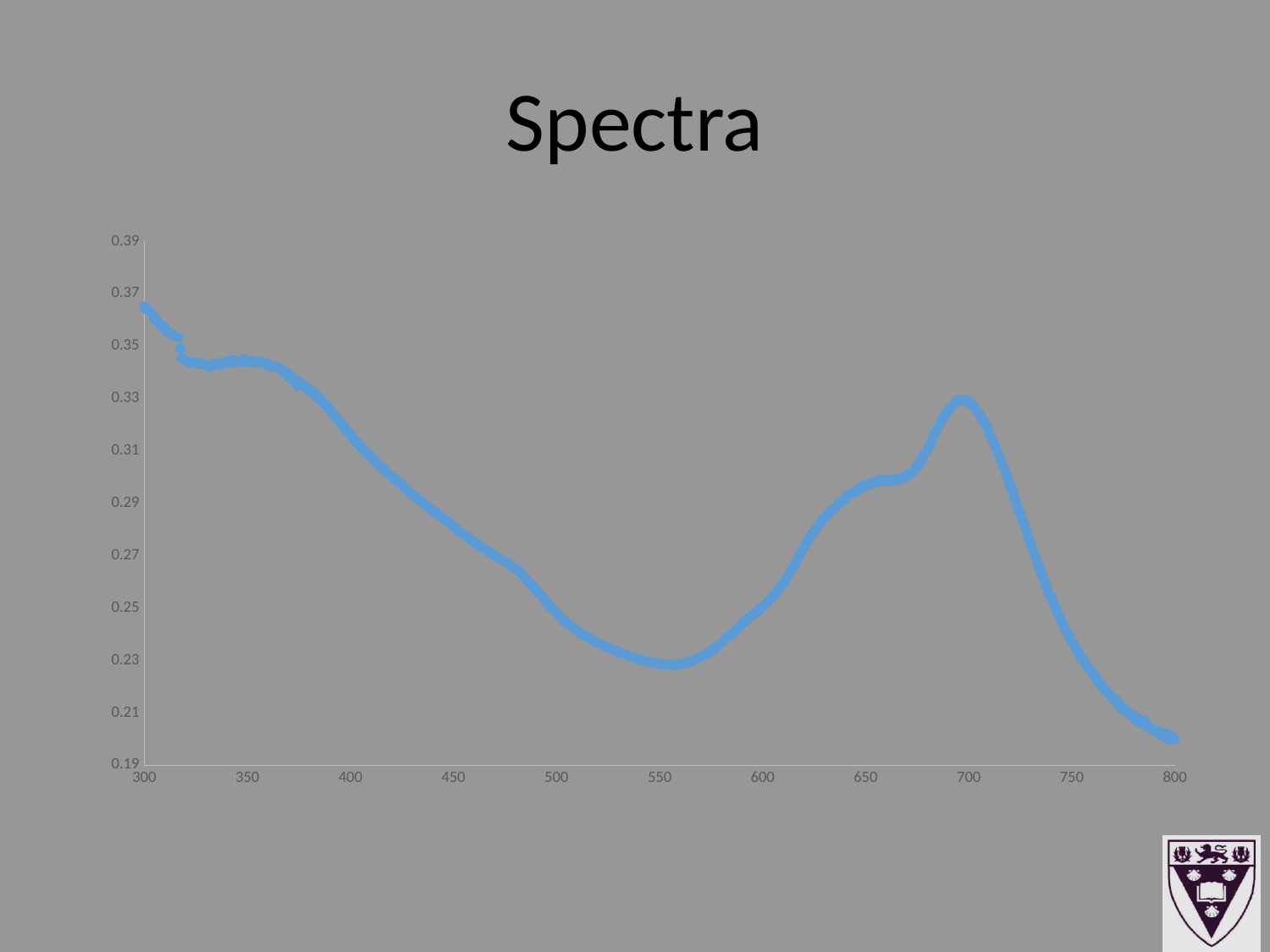
What is the range of the x axis shown on the chart? 300 to 800 What type of chart is shown on the slide? line chart Is the value at x = 700 greater or less than 0.31? greater Is the value at x = 300 greater or less than 0.35? greater Does the line rise or fall between x = 550 and x = 700? rise What is the title of the chart? Spectra Is the value at x = 800 greater or less than 0.21? less Does the line rise or fall between x = 700 and x = 800? fall Which is larger, the value at x = 400 or the value at x = 600? x = 400 Does the line rise or fall between x = 300 and x = 550? fall How many series are plotted on the chart? 1